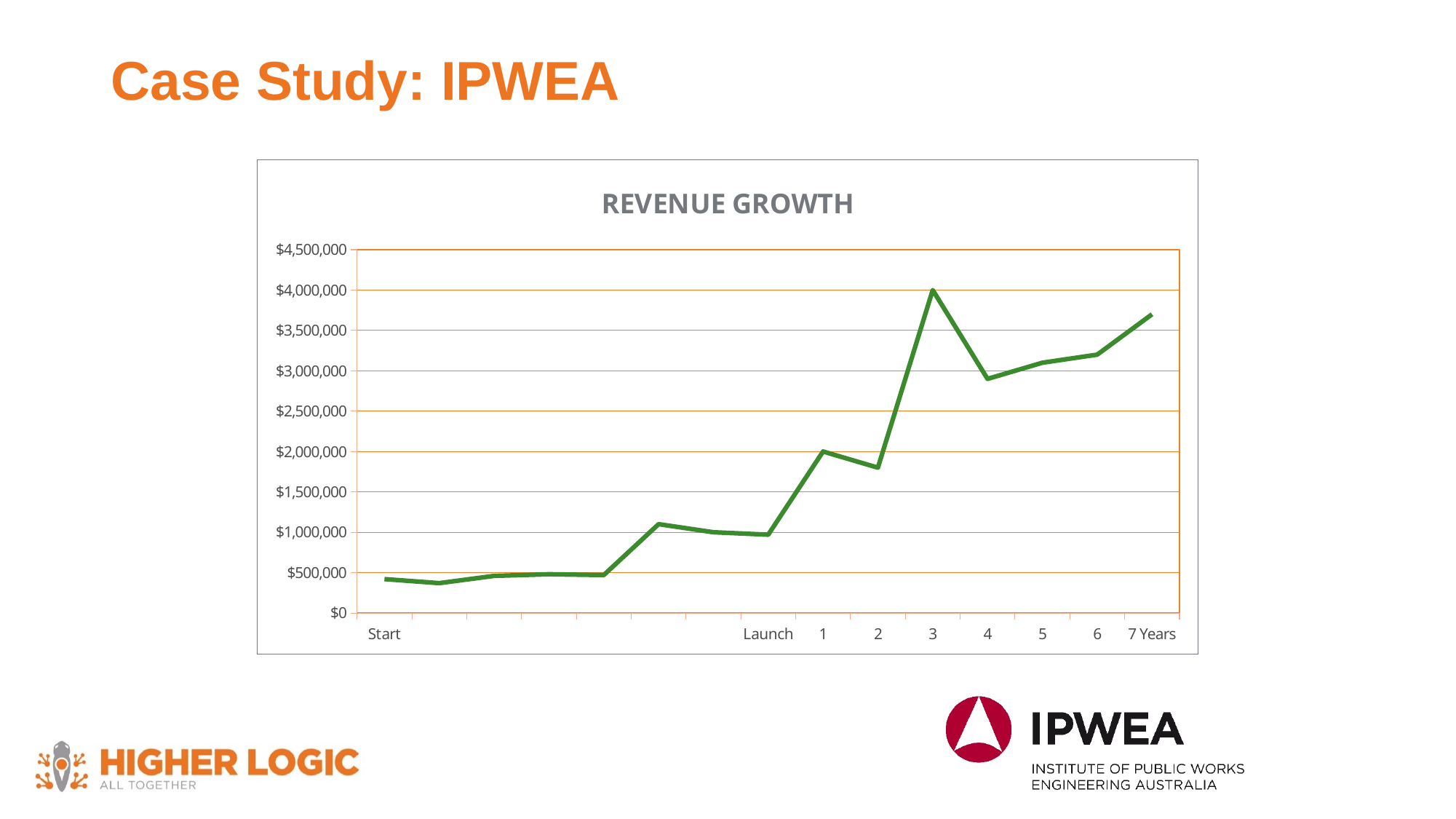
Is the revenue at Start greater or less than $500,000? less What is the revenue value at year 1? $2,000,000 Is the revenue at 7 Years greater or less than $3,500,000? greater Overall, does revenue rise or fall from Start to 7 Years? rise Is the revenue at year 2 greater or less than $2,000,000? less What is the revenue value at year 3? $4,000,000 What is the title of the chart? REVENUE GROWTH Which is larger, the revenue at Launch or the revenue at year 1? year 1 At which x-axis label does revenue reach its highest point? 3 Which is larger, the revenue at year 3 or the revenue at year 4? year 3 What kind of chart is shown on the slide? line chart